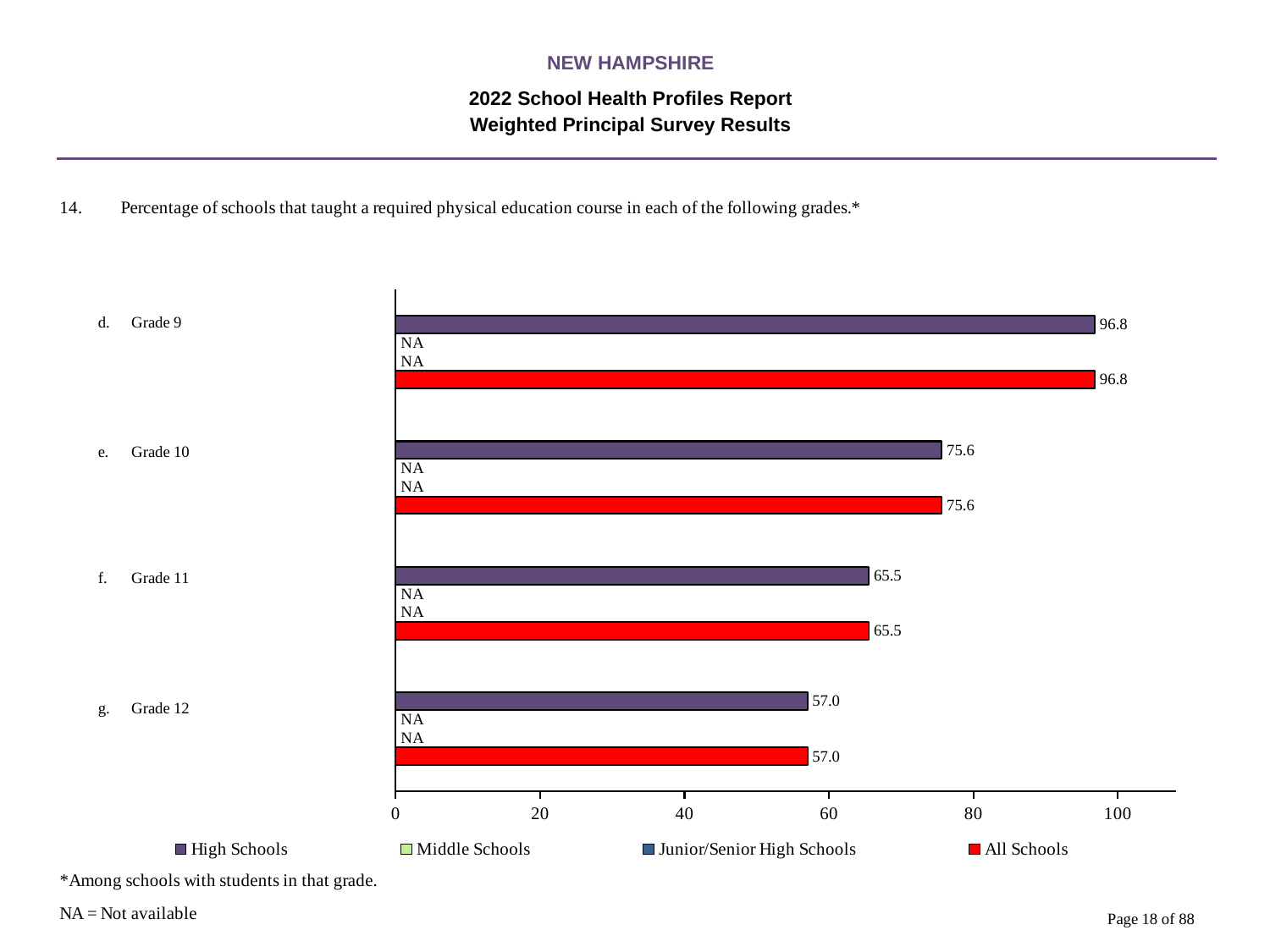
Which grade has the highest value for High Schools? Grade 9 How many grades are shown on the chart? 4 What is the value for High Schools for Grade 11? 65.5 What kind of chart is shown on the slide? Bar chart Which is larger for High Schools: Grade 10 or Grade 11? Grade 10 What is the value for All Schools for Grade 12? 57.0 What value is shown for Middle Schools for Grade 9? NA What is the value for All Schools for Grade 10? 75.6 How many series does the legend list? 4 Which grade has the lowest value for All Schools? Grade 12 What is the difference between the High Schools values for Grade 9 and Grade 12? 39.8 What is the value for High Schools for Grade 9? 96.8